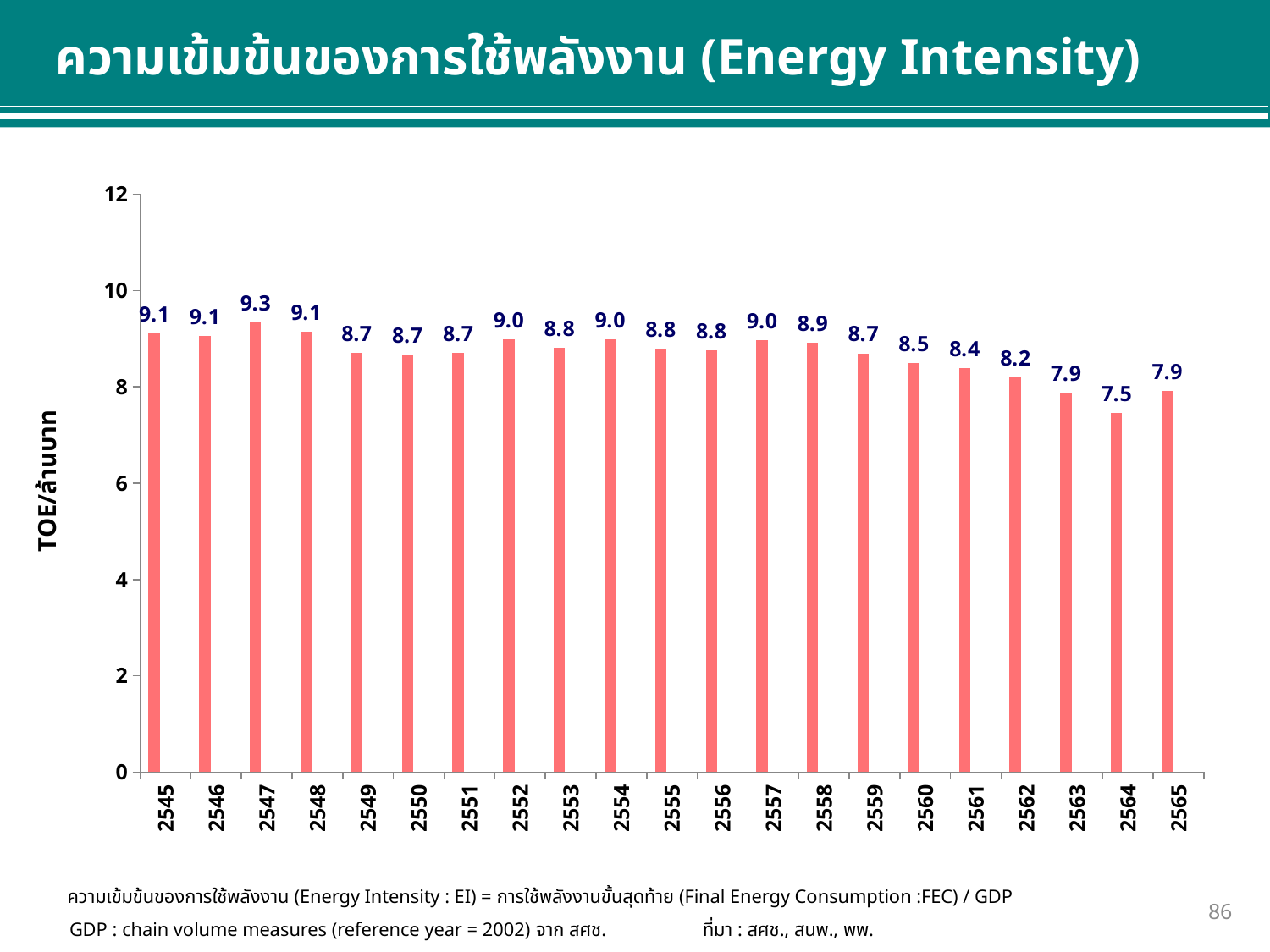
What is the energy intensity value for 2547? 9.3 What is the label on the y axis? TOE/ล้านบาท What is the value shown for 2560? 8.5 Is the value for 2563 greater or less than 8? less Which year has the lowest energy intensity? 2564 What is the value shown for 2564? 7.5 What is the difference between the values for 2545 and 2565? 1.2 What kind of chart is shown on the slide? bar chart Which year has the highest energy intensity? 2547 Which is larger, the value for 2557 or the value for 2561? 2557 How many years are shown on the x axis? 21 What is the difference between the values for 2547 and 2564? 1.8